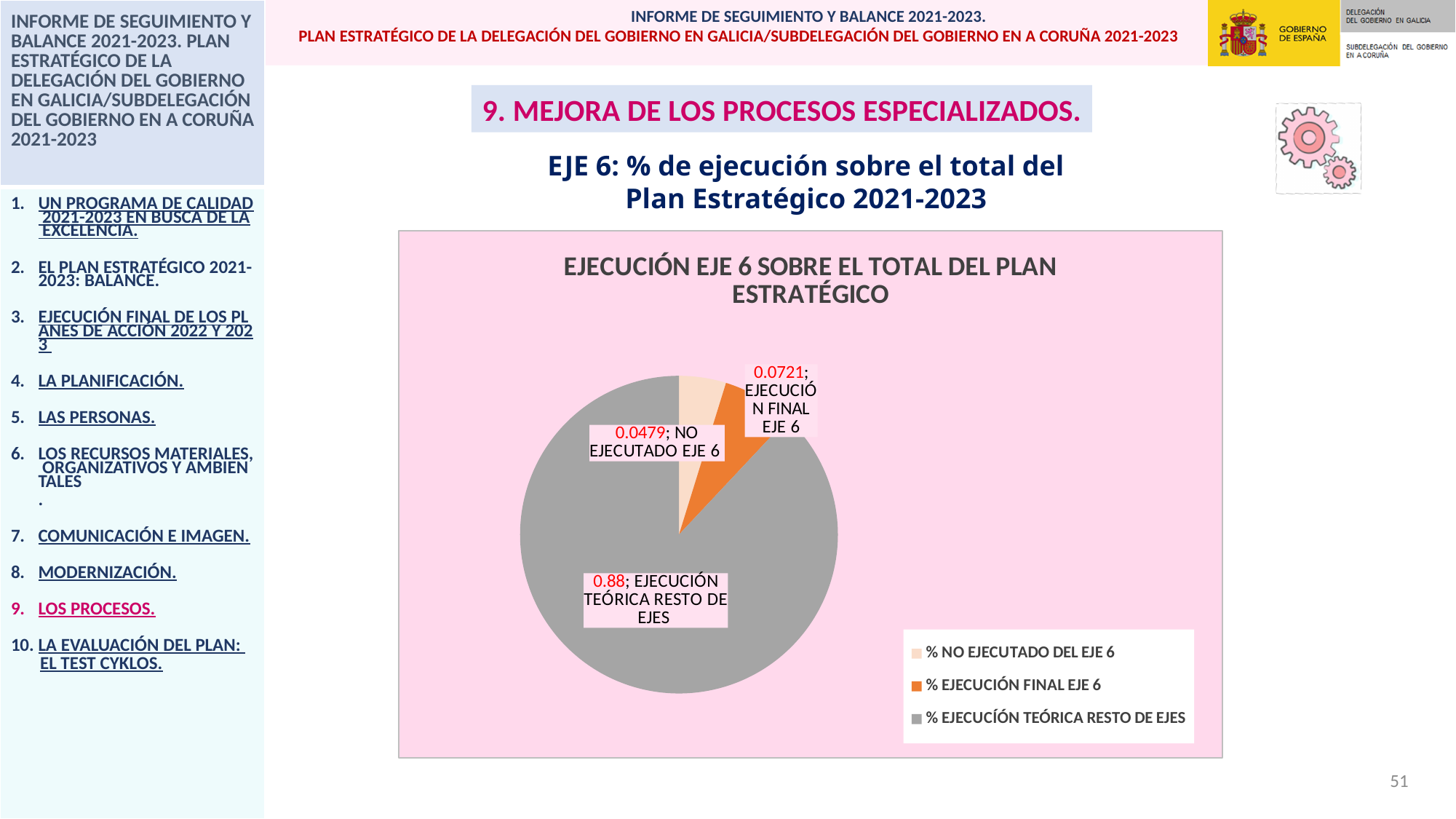
What is the value shown for EJECUCIÓN TEÓRICA RESTO DE EJES? 0.88 What is the title of the chart? EJECUCIÓN EJE 6 SOBRE EL TOTAL DEL PLAN ESTRATÉGICO Which slice is the smallest in the pie chart? NO EJECUTADO EJE 6 Which slice is the largest in the pie chart? EJECUCIÓN TEÓRICA RESTO DE EJES What is the difference between the values for EJECUCIÓN FINAL EJE 6 and NO EJECUTADO EJE 6? 0.0242 What is the value shown for NO EJECUTADO EJE 6? 0.0479 How many slices does the pie chart have? 3 Which is larger, EJECUCIÓN FINAL EJE 6 or NO EJECUTADO EJE 6? EJECUCIÓN FINAL EJE 6 What kind of chart is shown on the slide? Pie chart What colour is the slice for % EJECUCIÓN FINAL EJE 6? Orange How many entries does the legend list? 3 What is the value shown for EJECUCIÓN FINAL EJE 6? 0.0721